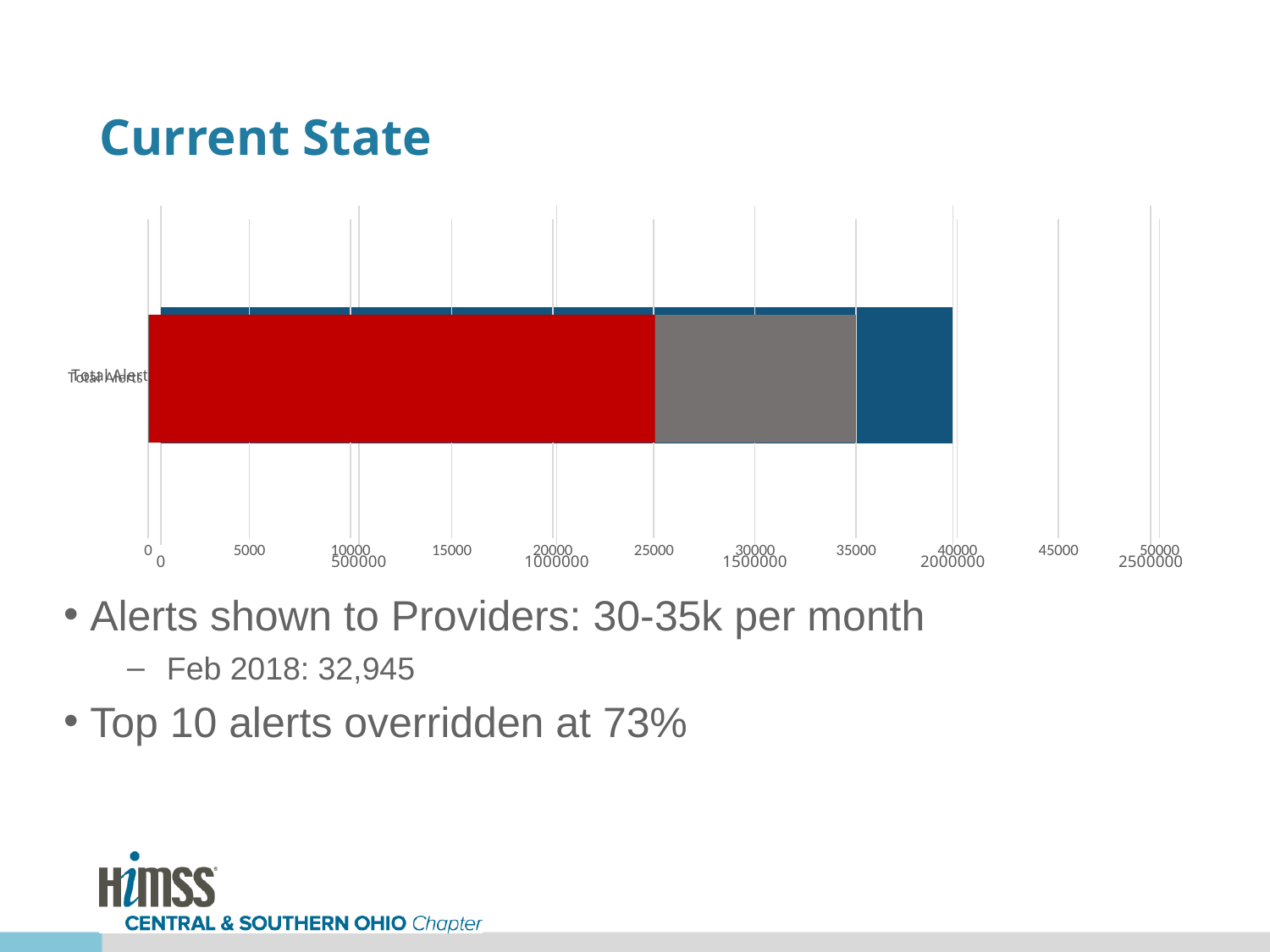
How many coloured segments make up the stacked bar? 3 Which coloured segment of the stacked bar is the narrowest? blue On the 0–50000 axis, does the full stacked bar end at a value greater or less than 45000? less What colour is the leftmost segment of the stacked bar? red Which coloured segment of the stacked bar is the widest? red What kind of chart is shown on the slide? bar chart Is the red segment wider or narrower than the gray segment? wider On the 0–50000 axis, does the full stacked bar end at a value greater or less than 35000? greater How many categories are plotted on the chart? 1 What is the category label on the chart's vertical axis? Total Alerts On the 0–50000 axis, does the red segment end at a value greater or less than 30000? less